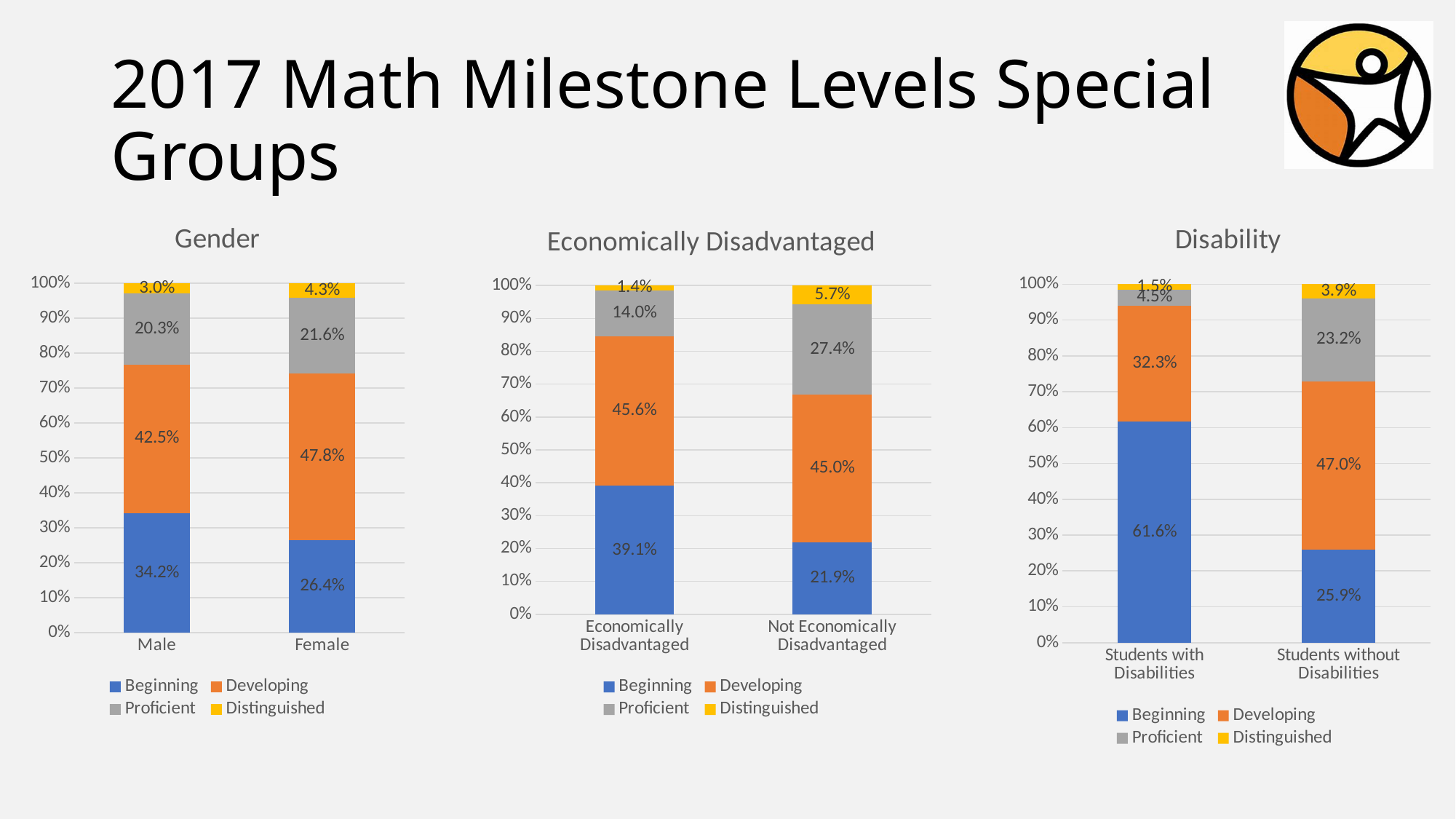
In the Economically Disadvantaged chart, which category has the higher Beginning value? Economically Disadvantaged In the Gender chart, what is the Developing value for Female? 47.8% How many categories are shown on the x axis of the Economically Disadvantaged chart? 2 How many series does the legend of the Gender chart list? 4 In the Disability chart, what is the Developing value for Students without Disabilities? 47.0% In the Disability chart, which category has the higher Proficient value? Students without Disabilities In the Economically Disadvantaged chart, what is the difference between the Distinguished values for Not Economically Disadvantaged and Economically Disadvantaged? 4.3% In the Disability chart, what is the Beginning value for Students with Disabilities? 61.6% In the Gender chart, what is the difference between the Proficient values for Female and Male? 1.3% What kind of chart is the Disability chart? Stacked bar chart In the Gender chart, what is the Beginning value for Male? 34.2% In the Economically Disadvantaged chart, what is the Proficient value for Not Economically Disadvantaged? 27.4%